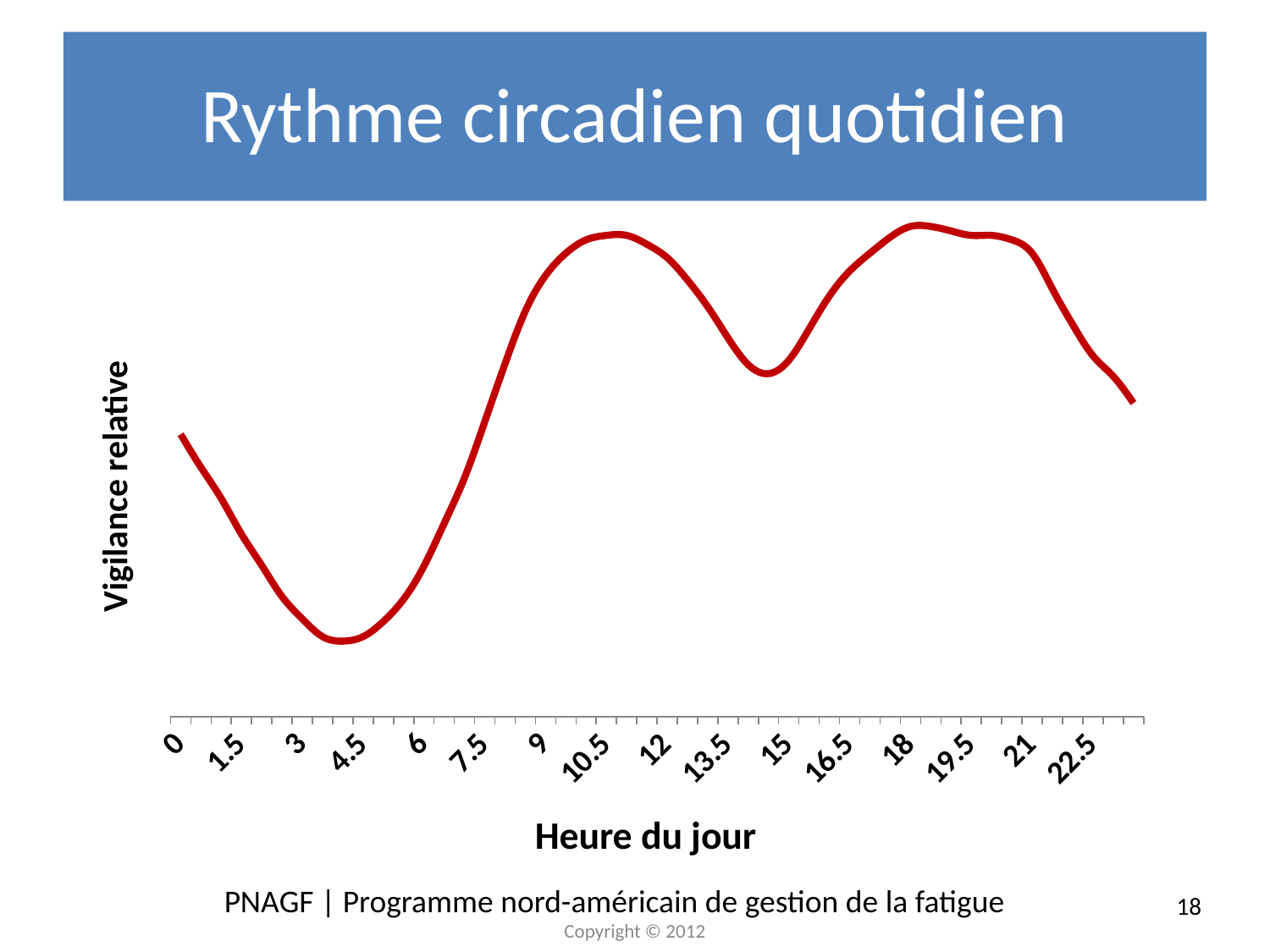
Does the curve rise or fall between hour 10.5 and hour 15? Fall Which is higher on the curve, the value at hour 0 or the value at hour 4.5? Hour 0 Which is higher on the curve, the value at hour 10.5 or the value at hour 15? Hour 10.5 Near which hour label does the curve reach its lowest point? 4.5 Does the curve rise or fall between hour 21 and the end of the axis? Fall How many labels are shown on the horizontal axis? 16 Does the curve rise or fall between hour 0 and hour 3? Fall What is the title of the chart on the slide? Rythme circadien quotidien Near which hour label does the curve reach its highest point? 18 What is the label of the horizontal axis? Heure du jour What type of chart is shown on the slide? Line chart